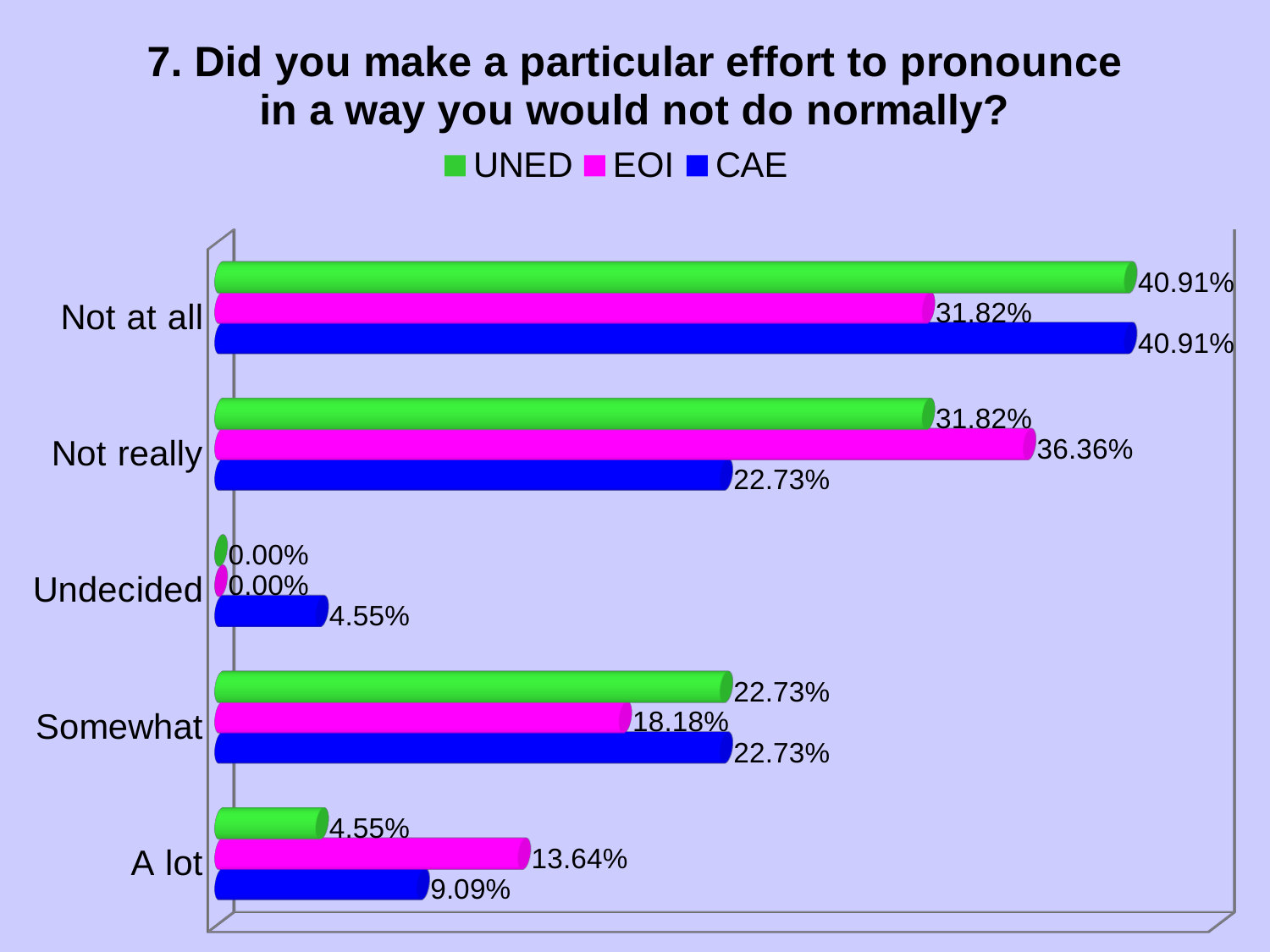
What is the difference between the CAE and UNED values in the "A lot" category? 4.54% How many categories are shown on the chart? 5 Which colour represents the CAE series in the legend? Blue In the "Not really" category, which is larger, the EOI value or the CAE value? EOI Which category has the lowest value for UNED? Undecided What is the value for EOI in the "Not really" category? 36.36% Which category has the highest value for EOI? Not really What kind of chart is shown on the slide? Bar chart What is the value for UNED in the "Not at all" category? 40.91% What is the value for EOI in the "A lot" category? 13.64% How many series does the legend list? 3 What is the value for CAE in the "Undecided" category? 4.55%